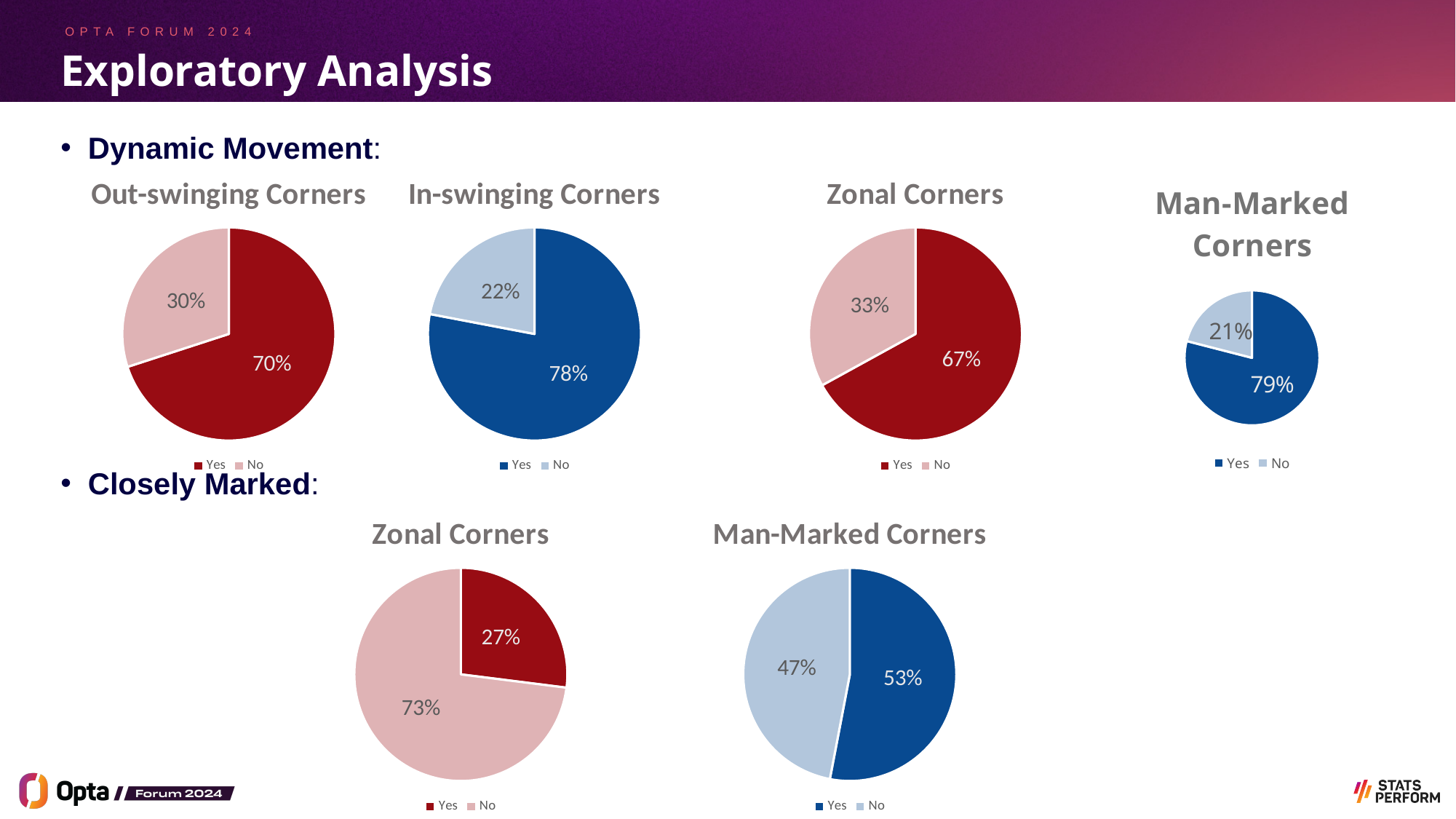
In the Dynamic Movement 'Man-Marked Corners' pie chart, what share is labelled 'No'? 21% In the Closely Marked 'Man-Marked Corners' pie chart, which slice is larger, 'Yes' or 'No'? Yes In the Closely Marked 'Man-Marked Corners' pie chart, what share is labelled 'Yes'? 53% In the Closely Marked 'Zonal Corners' pie chart, what share is labelled 'No'? 73% In the Closely Marked 'Zonal Corners' pie chart, what is the difference between the 'No' and 'Yes' shares? 46% What kind of chart is used for the 'In-swinging Corners' chart under Dynamic Movement? Pie chart In the Dynamic Movement 'Out-swinging Corners' pie chart, what share is labelled 'Yes'? 70% In the Dynamic Movement 'In-swinging Corners' pie chart, what share is labelled 'No'? 22% In the Dynamic Movement 'Out-swinging Corners' pie chart, what is the difference between the 'Yes' and 'No' shares? 40% In the Dynamic Movement 'Zonal Corners' pie chart, what share is labelled 'Yes'? 67% How many entries does the legend of the Closely Marked 'Zonal Corners' pie chart list? 2 How many pie charts are shown on the slide in total? 6